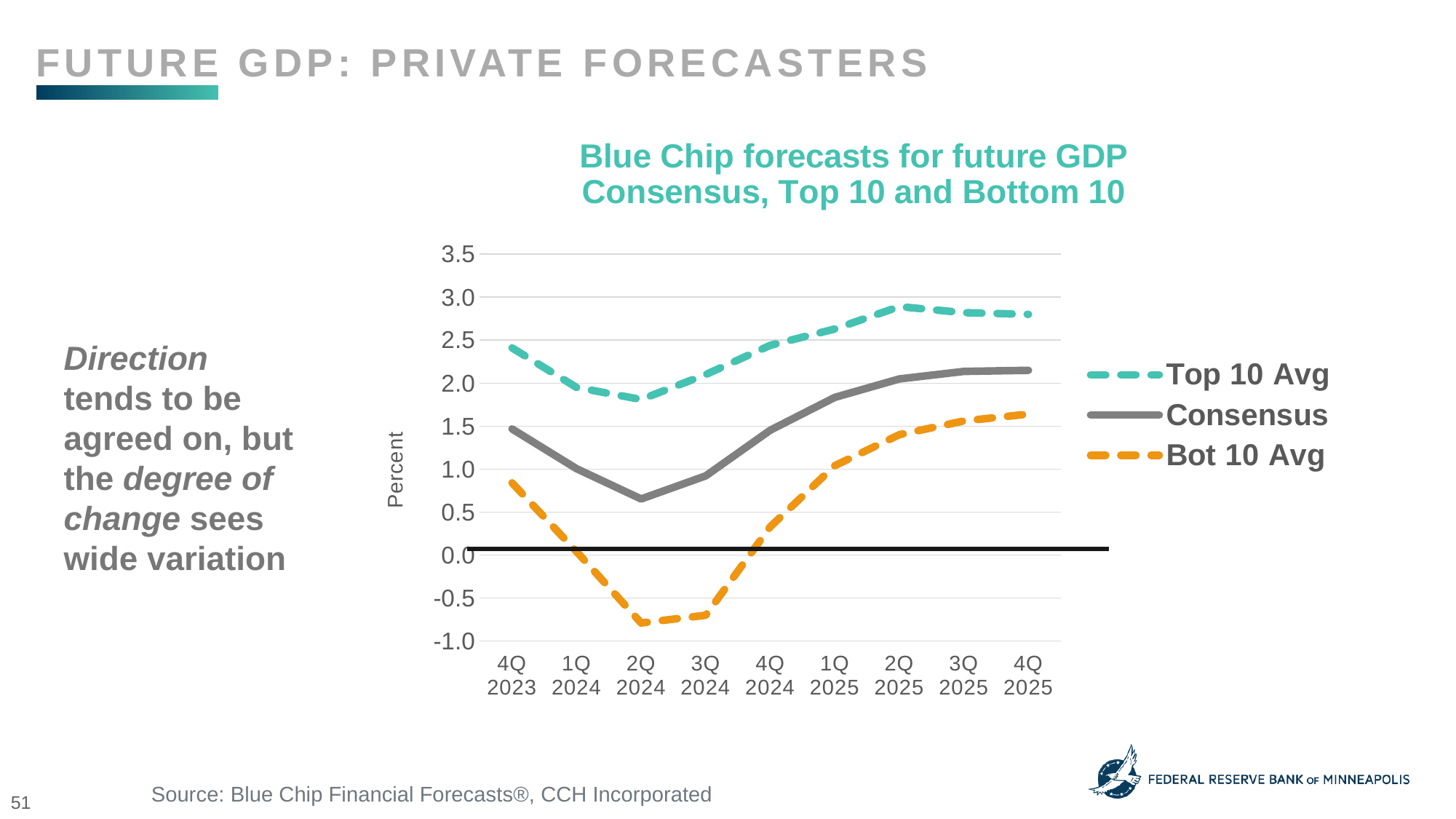
Is the Top 10 Avg value for 4Q 2023 greater or less than 2.0? greater At 4Q 2024, which is higher: Top 10 Avg or Consensus? Top 10 Avg Is the Consensus value for 2Q 2024 greater or less than 1.0? less In which quarter is the Consensus forecast at its lowest? 2Q 2024 How many quarters are plotted along the x axis? 9 Is the Bot 10 Avg value for 2Q 2024 greater or less than 0.0? less What is the label on the vertical axis? Percent Does the Consensus line rise or fall from 2Q 2024 to 4Q 2025? Rise How many series does the legend list? 3 In which quarter is the Bot 10 Avg forecast at its lowest? 2Q 2024 What kind of chart is shown on the slide? Line chart